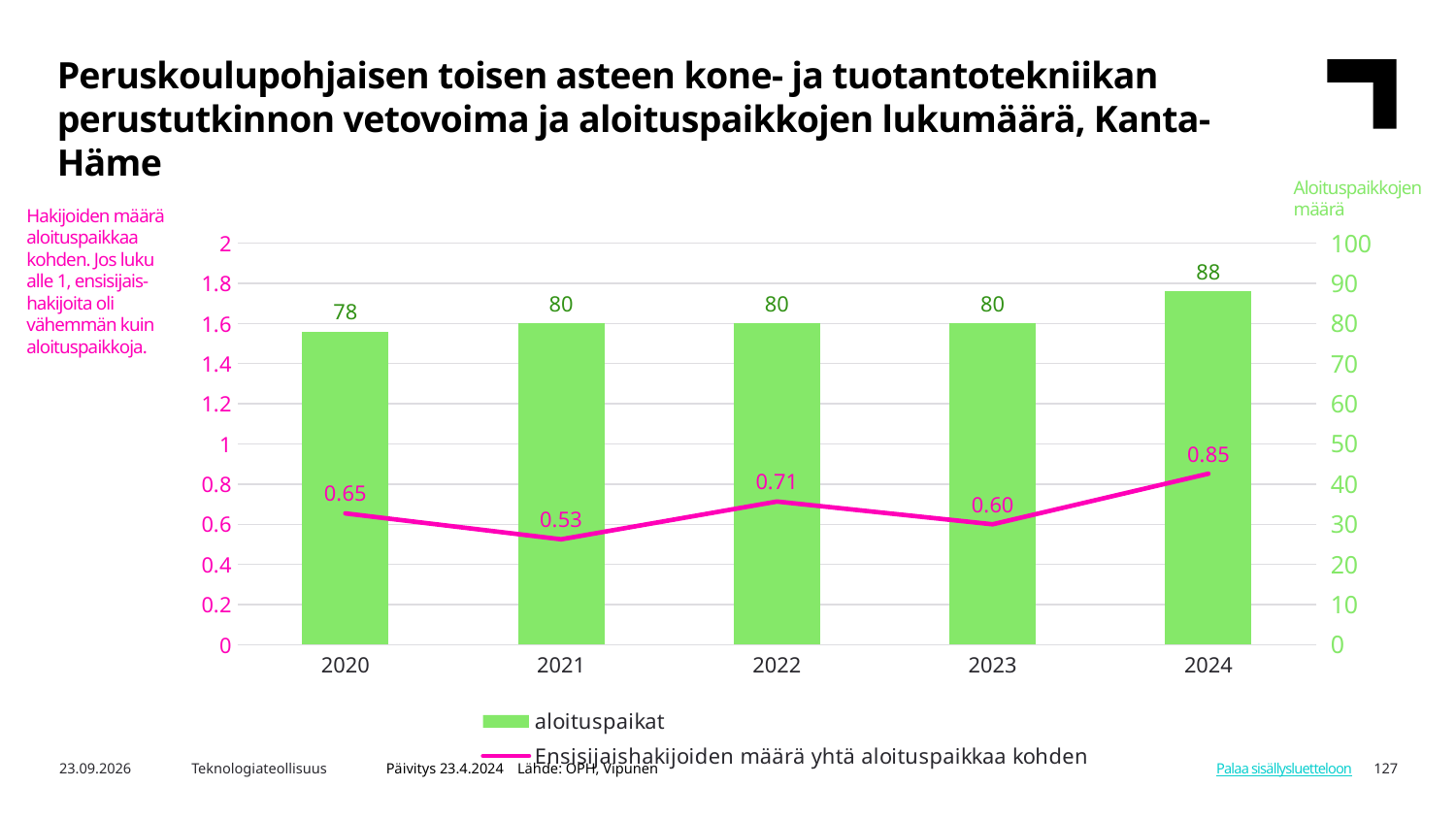
In which year is Ensisijaishakijoiden määrä yhtä aloituspaikkaa kohden highest? 2024 What is the value of aloituspaikat for 2020? 78 What is the value of aloituspaikat for 2024? 88 How many series does the legend list? 2 How many years are shown on the x axis of the chart? 5 Which year has a higher value of Ensisijaishakijoiden määrä yhtä aloituspaikkaa kohden, 2020 or 2022? 2022 In which year is Ensisijaishakijoiden määrä yhtä aloituspaikkaa kohden lowest? 2021 In which year is aloituspaikat lowest? 2020 What is the value of Ensisijaishakijoiden määrä yhtä aloituspaikkaa kohden for 2021? 0.53 What is the difference in aloituspaikat between 2024 and 2023? 8 What is the difference in Ensisijaishakijoiden määrä yhtä aloituspaikkaa kohden between 2022 and 2023? 0.11 What colour are the aloituspaikat bars? Green